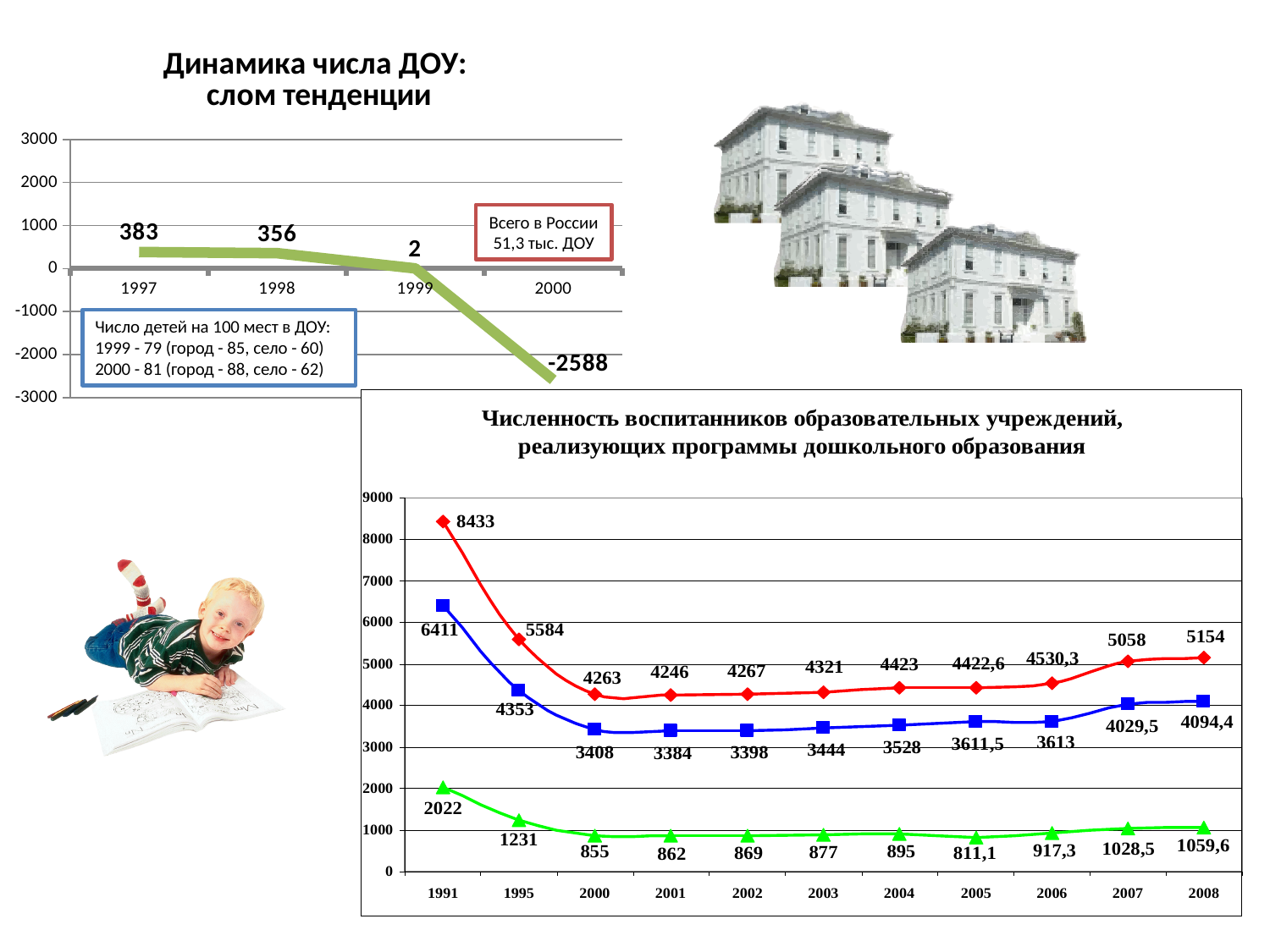
In the chart 'Численность воспитанников образовательных учреждений', in which year does the blue series reach its lowest value? 2001 In the chart 'Динамика числа ДОУ: слом тенденции', how many years are plotted on the x axis? 4 In the chart 'Численность воспитанников образовательных учреждений', what is the value of the green series for 2005? 811,1 In the chart 'Динамика числа ДОУ: слом тенденции', do the values rise or fall from 1997 to 2000? fall In the chart 'Динамика числа ДОУ: слом тенденции', what is the value for 2000? -2588 In the chart 'Численность воспитанников образовательных учреждений', what is the value of the red series for 1991? 8433 In the chart 'Динамика числа ДОУ: слом тенденции', what is the difference between the values for 1997 and 1998? 27 In the chart 'Численность воспитанников образовательных учреждений', what is the difference between the red series values for 2008 and 2007? 96 In the chart 'Динамика числа ДОУ: слом тенденции', which year has the lowest value? 2000 In the chart 'Динамика числа ДОУ: слом тенденции', what is the value for 1997? 383 In the chart 'Численность воспитанников образовательных учреждений', what is the value of the blue series for 2008? 4094,4 In the chart 'Численность воспитанников образовательных учреждений', how many years are shown on the x axis? 11